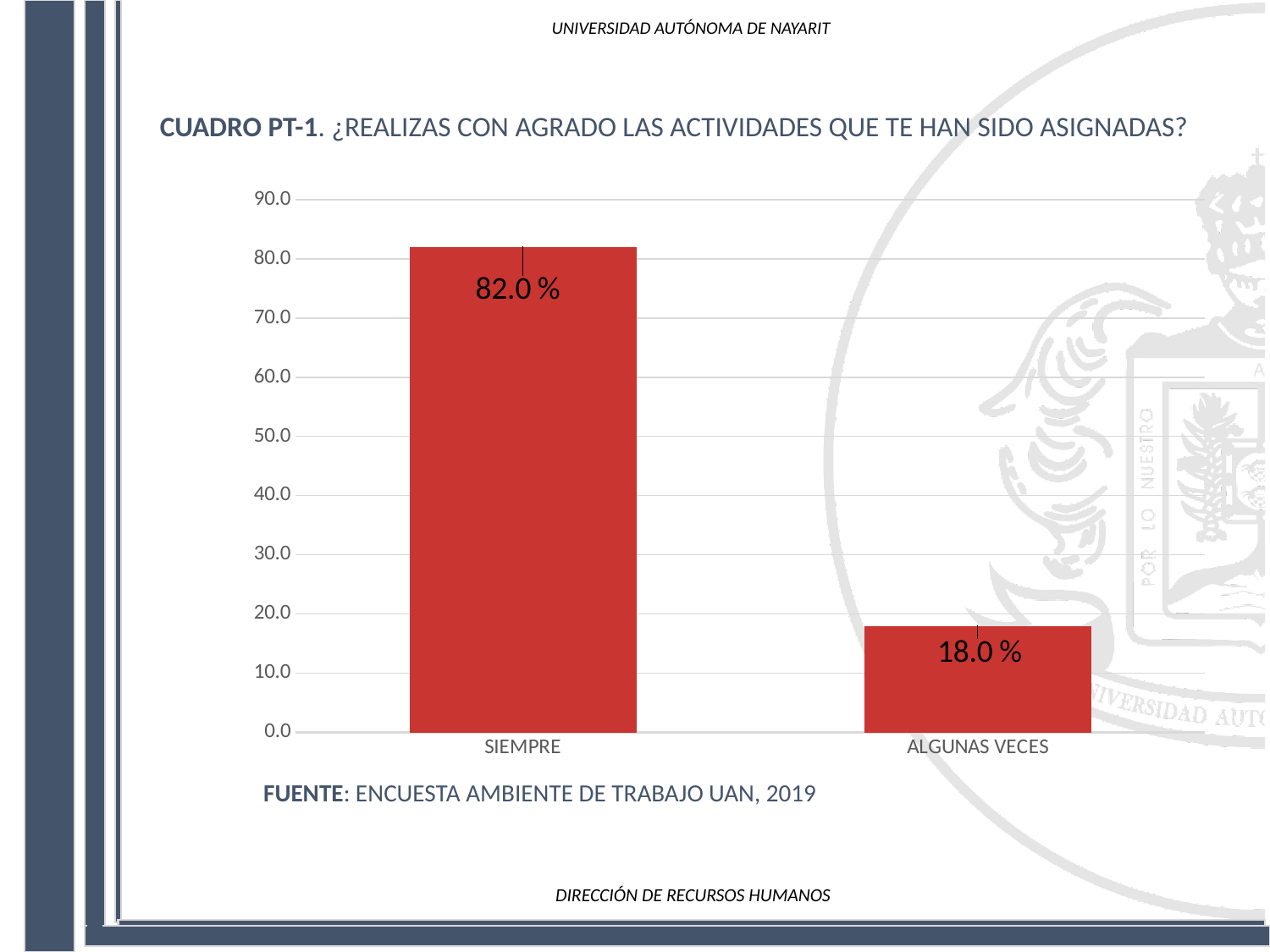
Is the value for SIEMPRE greater or less than 80.0? greater Which category has the lowest value? ALGUNAS VECES What is the value for SIEMPRE? 82.0 % What is the value for ALGUNAS VECES? 18.0 % Which category has the highest value? SIEMPRE Is the value for ALGUNAS VECES greater or less than 20.0? less Which is larger, the value for SIEMPRE or the value for ALGUNAS VECES? SIEMPRE How many categories are shown on the x axis? 2 What kind of chart is shown on the slide? bar chart What is the source cited below the chart? ENCUESTA AMBIENTE DE TRABAJO UAN, 2019 What is the difference between the values for SIEMPRE and ALGUNAS VECES? 64.0 % What colour are the bars in the chart? red